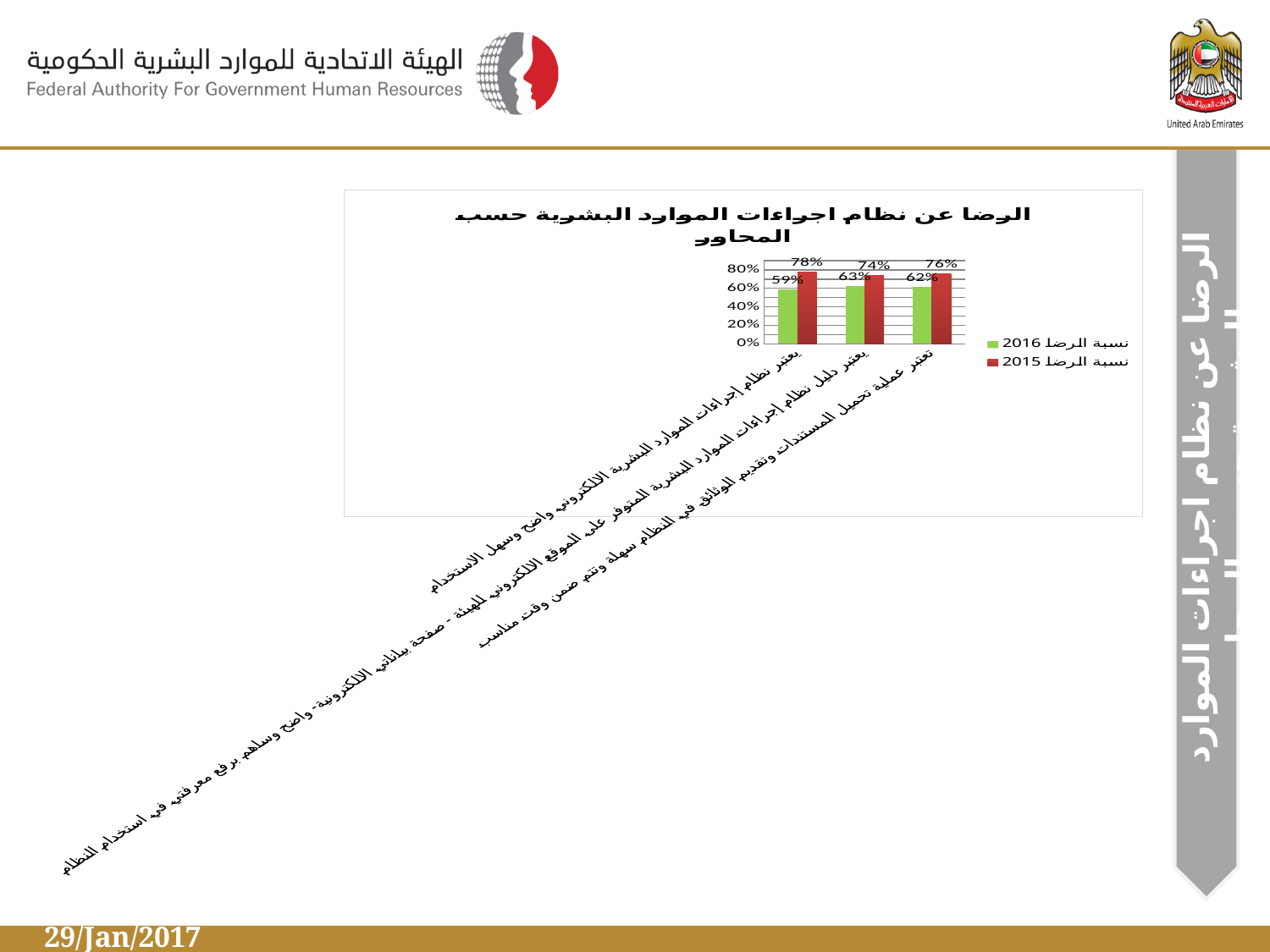
What is the 2016 satisfaction rate for the middle category, about the system guide (دليل نظام إجراءات الموارد البشرية)? 63% What type of chart is shown on the slide? bar chart What is the 2016 satisfaction rate (نسبة الرضا 2016) for the first (leftmost) category, 'يعتبر نظام إجراءات الموارد البشرية الالكتروني واضح وسهل الاستخدام'? 59% What is the difference between the 2015 and 2016 satisfaction rates for the first (leftmost) category? 19% How many series does the chart legend list? 2 Which category has the lowest 2016 satisfaction rate? يعتبر نظام إجراءات الموارد البشرية الالكتروني واضح وسهل الاستخدام (first category) Which category has the highest 2015 satisfaction rate? يعتبر نظام إجراءات الموارد البشرية الالكتروني واضح وسهل الاستخدام (first category) How many categories are plotted on the x axis of the chart? 3 For the middle category, which is larger: the 2016 satisfaction rate or the 2015 satisfaction rate? 2015 (74%) What colour represents the series نسبة الرضا 2016 in the chart? green What is the 2015 satisfaction rate (نسبة الرضا 2015) for the first (leftmost) category? 78% What is the 2015 satisfaction rate for the third (rightmost) category, about uploading documents (عملية تحميل المستندات)? 76%